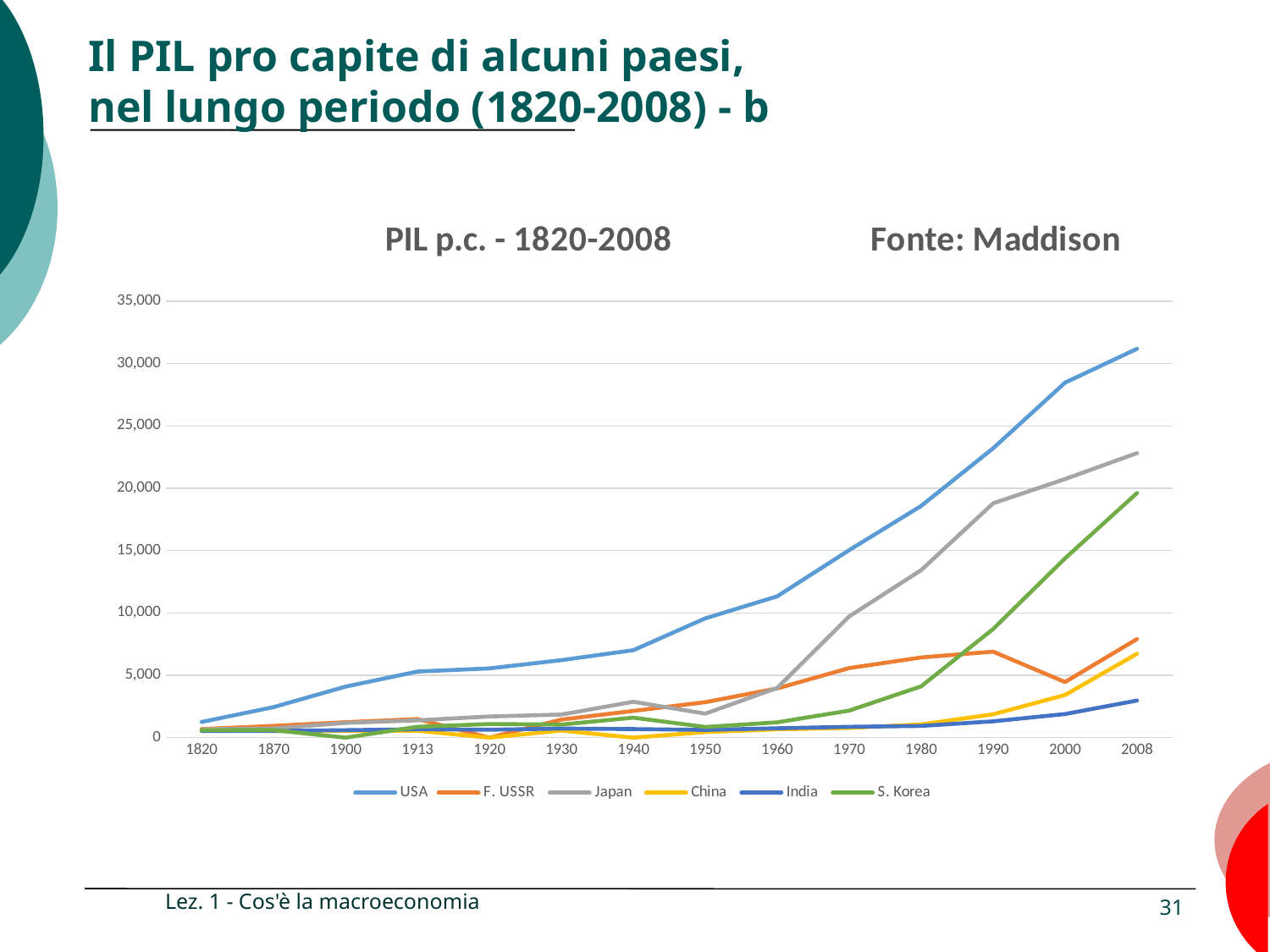
Is the value for USA in 1960 greater or less than 10,000? greater In 2008, which is larger: the value for S. Korea or the value for F. USSR? S. Korea How many years are marked on the x axis? 14 Is the value for Japan in 2008 greater or less than 25,000? less Which country has the highest GDP per capita in 2008? USA Which country has the lowest GDP per capita in 2008? India How many series does the legend list? 6 Is the value for India in 2008 greater or less than 5,000? less Does the USA line rise or fall from 1820 to 2008? rise What source is cited in the chart title? Maddison What kind of chart is shown on the slide? line chart